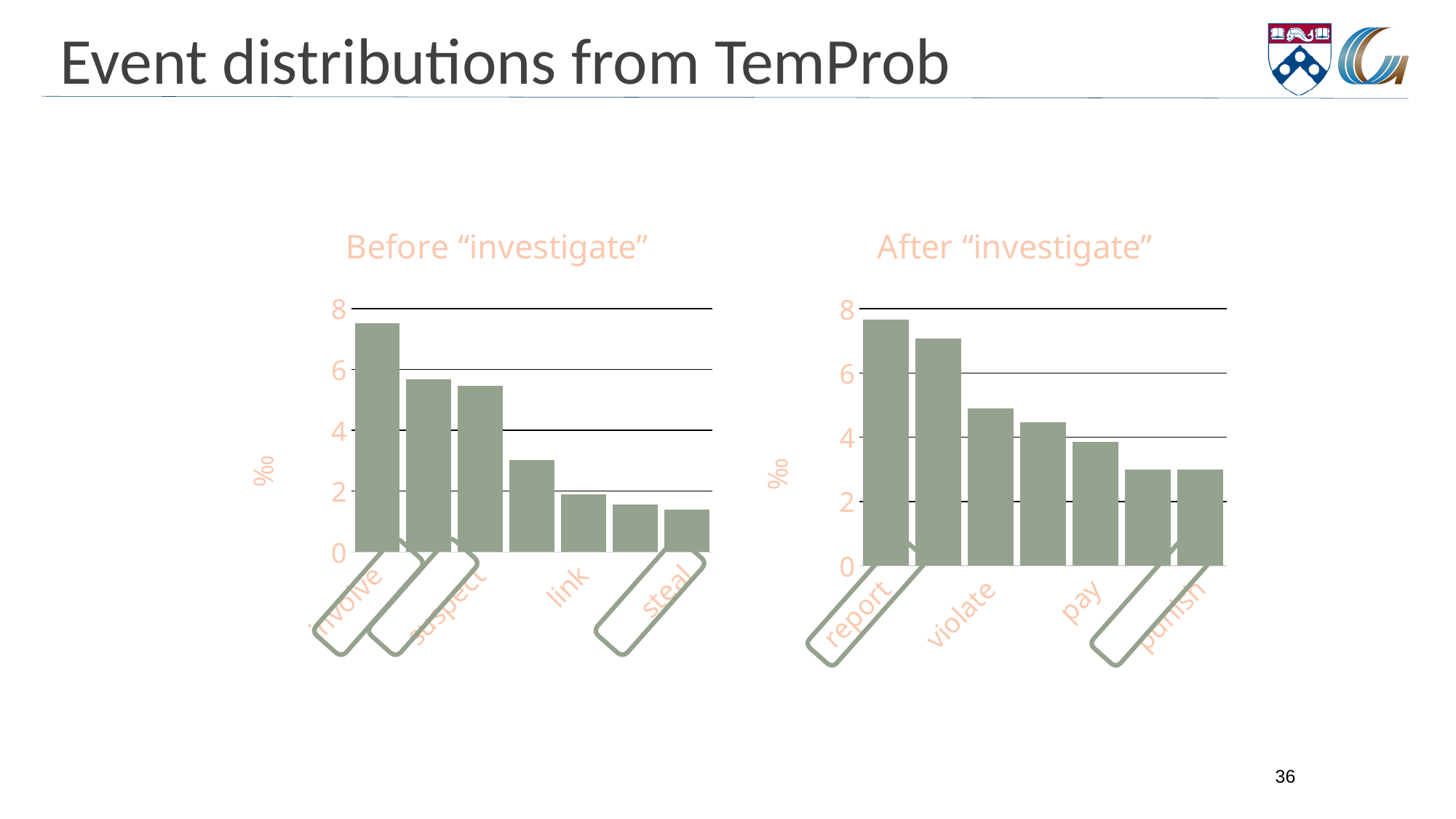
What is the title of the chart on the left of the slide? Before "investigate" In the "Before "investigate"" chart, which category has the highest value? involve In the "After "investigate"" chart, is the value for punish greater or less than 4? less In the "Before "investigate"" chart, is the value for involve greater or less than 6? greater In the "Before "investigate"" chart, do the bar values rise or fall from left to right? fall In the "After "investigate"" chart, which category has the highest value? report How many bars does the "Before "investigate"" chart have? 7 In the "After "investigate"" chart, is the value for report greater or less than 6? greater In the "After "investigate"" chart, do the bar values rise or fall from left to right? fall What kind of chart is the "Before "investigate"" chart? bar chart What unit is shown on the y axis of the "After "investigate"" chart? ‰ How many bars does the "After "investigate"" chart have? 7